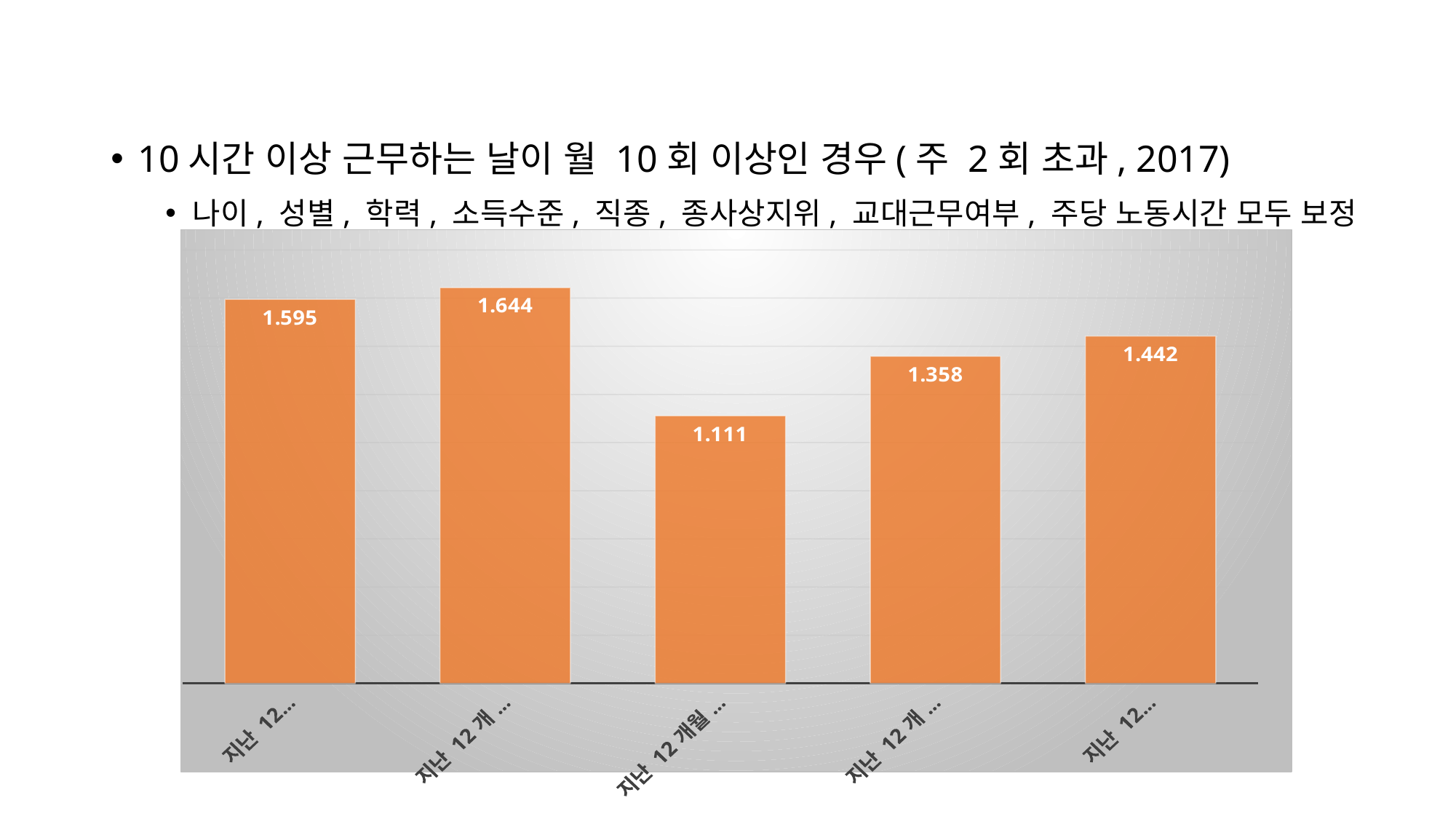
What is the value of the first (leftmost) bar? 1.595 What is the difference between the highest value (1.644) and the lowest value (1.111)? 0.533 What type of chart is shown on the slide? bar chart What is the value of the last (rightmost) bar? 1.442 What is the value of the fourth bar from the left? 1.358 What is the value of the second bar from the left? 1.644 How many bars are plotted in the chart? 5 Which bar has the highest value? the second bar (1.644) Which bar has the lowest value? the third bar (1.111) What is the value of the middle (third) bar? 1.111 Do the values rise or fall from the third bar to the fifth bar? rise Which is larger, the value of the first bar or the value of the last bar? the first bar (1.595)